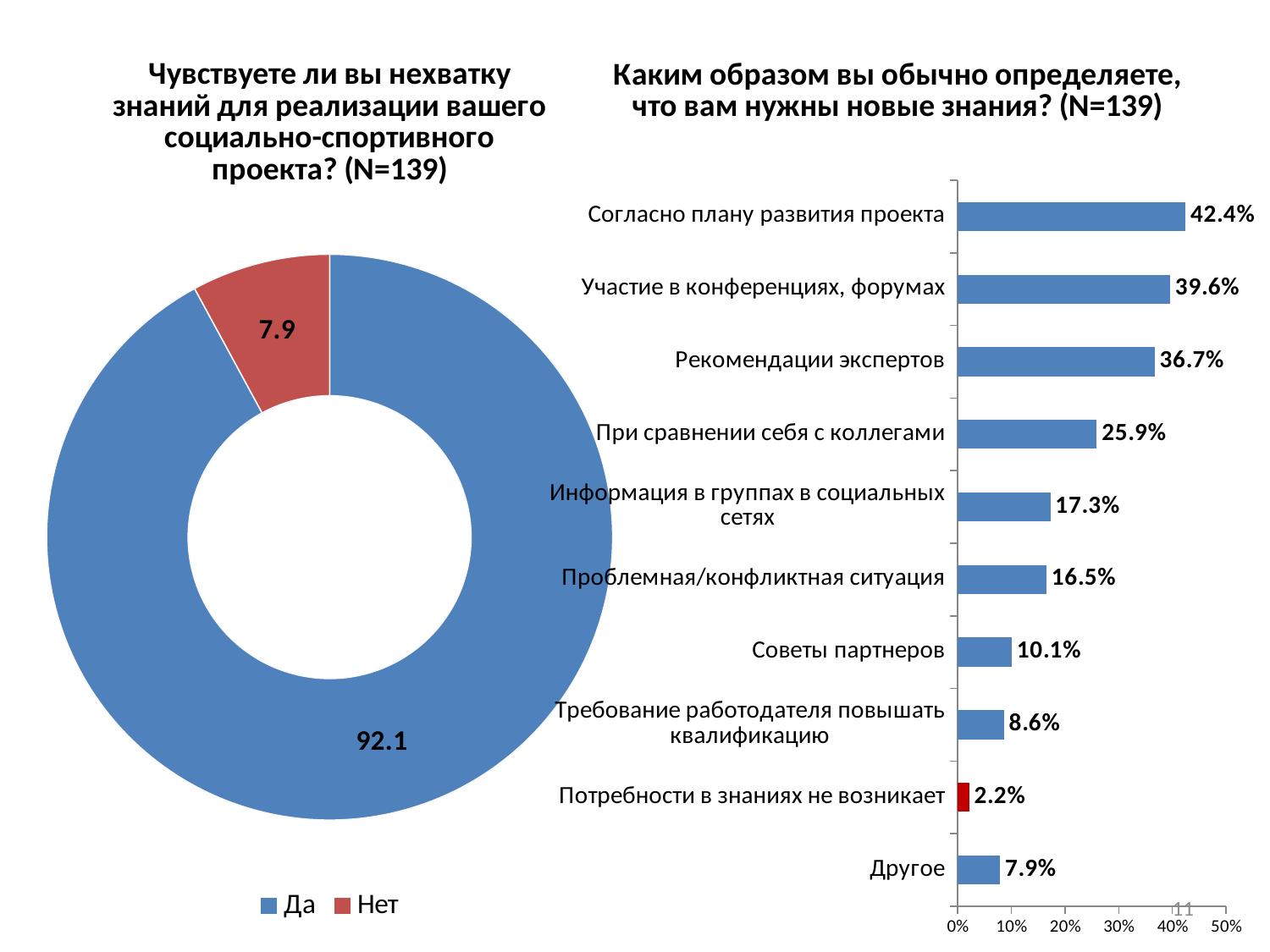
In the right chart (Каким образом вы обычно определяете...), which is larger: Информация в группах в социальных сетях or Проблемная/конфликтная ситуация? Информация в группах в социальных сетях What kind of chart is the left chart (Чувствуете ли вы нехватку знаний...)? Doughnut (pie) chart How many entries does the legend of the left chart (Чувствуете ли вы нехватку знаний...) list? 2 How many categories are shown in the right chart (Каким образом вы обычно определяете...)? 10 In the left chart (Чувствуете ли вы нехватку знаний...), what is the value for Нет? 7.9 In the right chart (Каким образом вы обычно определяете...), what is the difference between Согласно плану развития проекта and Участие в конференциях, форумах? 2.8% In the right chart (Каким образом вы обычно определяете...), what is the value for Советы партнеров? 10.1% What kind of chart is the right chart (Каким образом вы обычно определяете...)? Bar chart In the right chart (Каким образом вы обычно определяете...), which category has the lowest value? Потребности в знаниях не возникает In the right chart (Каким образом вы обычно определяете...), which category has the highest value? Согласно плану развития проекта In the left chart (Чувствуете ли вы нехватку знаний...), what is the value for Да? 92.1 In the right chart (Каким образом вы обычно определяете...), what is the value for Рекомендации экспертов? 36.7%